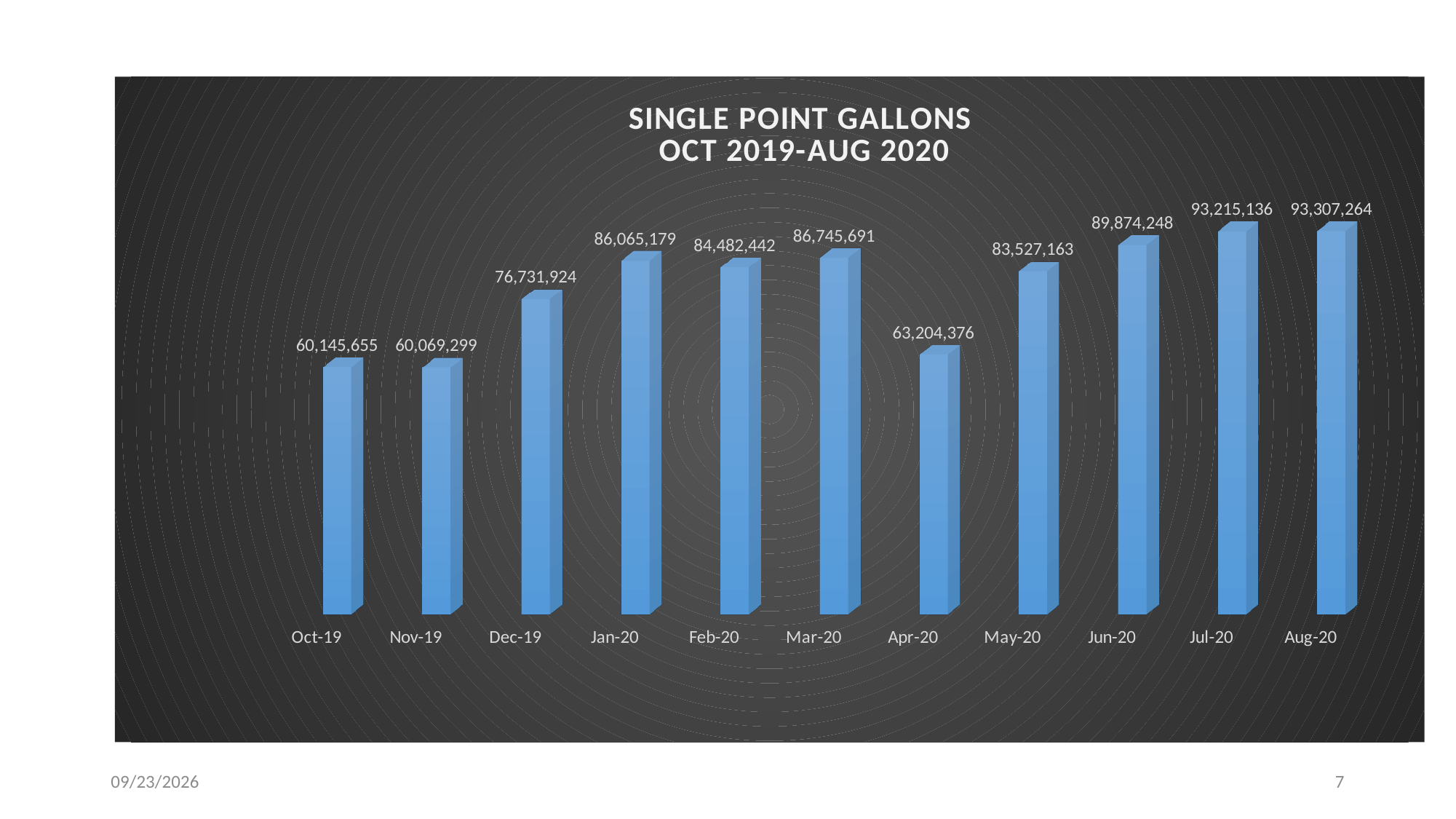
What kind of chart is this? Bar chart Do the values rise or fall from Apr-20 to Aug-20? Rise Which month has the highest value? Aug-20 What is the title of the chart? SINGLE POINT GALLONS OCT 2019-AUG 2020 What is the value for Dec-19? 76,731,924 Which is larger, the value for Feb-20 or the value for May-20? Feb-20 How many months are shown on the chart? 11 What is the difference between the values for Jan-20 and Dec-19? 9,333,255 What is the difference between the values for Mar-20 and Apr-20? 23,541,315 Which month has the lowest value? Nov-19 What is the value for Apr-20? 63,204,376 What is the value for Jun-20? 89,874,248